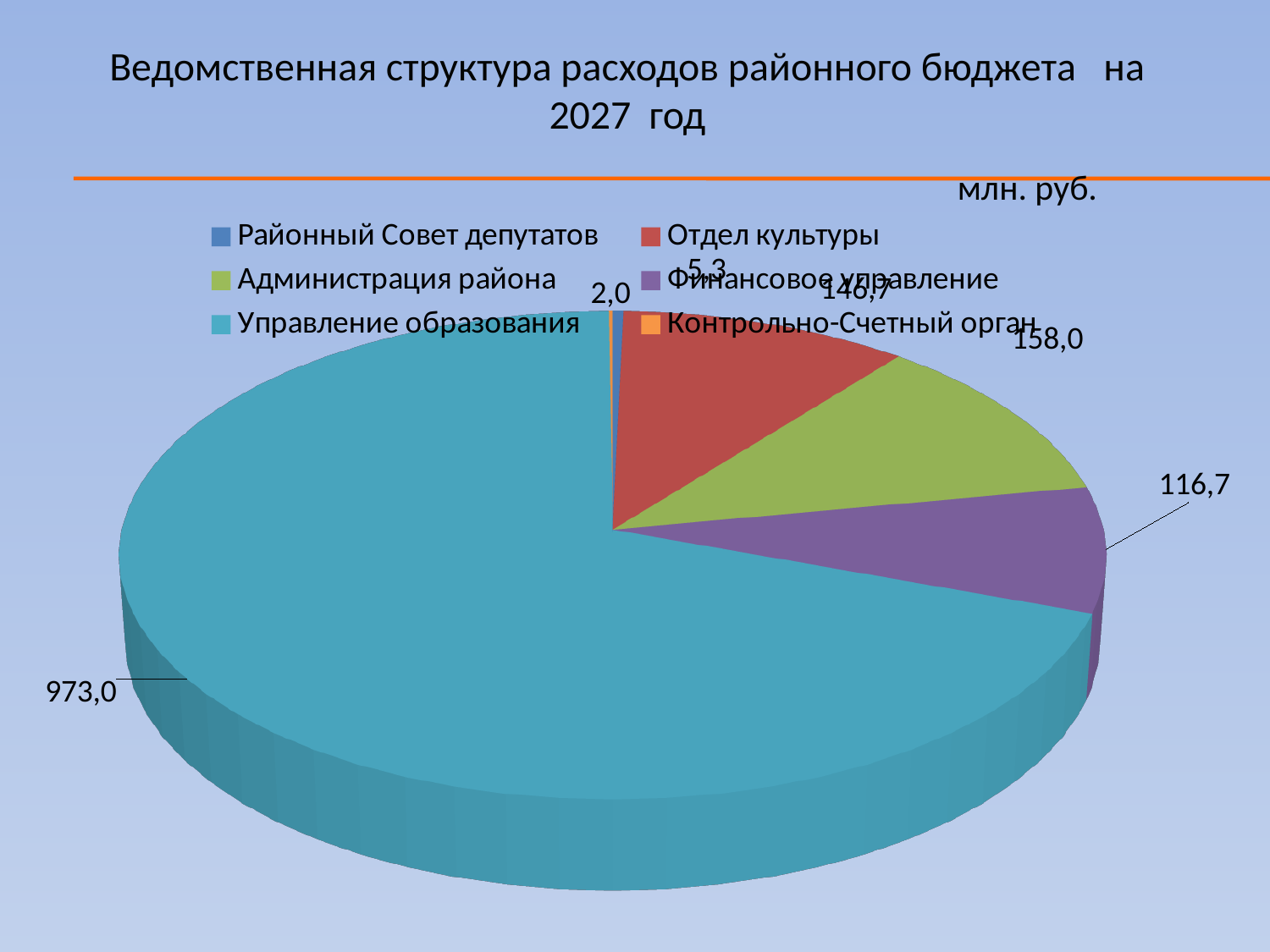
What is the value for Финансовое управление? 116,7 What is the value for Отдел культуры? 146,7 What is the difference between the values for Администрация района and Отдел культуры? 11,3 What is the difference between the values for Управление образования and Финансовое управление? 856,3 What is the value for Управление образования? 973,0 How many categories does the legend list? 6 Which is smaller, Финансовое управление or Отдел культуры? Финансовое управление What is the value for Администрация района? 158,0 Which is larger, Администрация района or Отдел культуры? Администрация района What kind of chart is shown on the slide? pie chart Which category has the largest slice of the pie? Управление образования In what units are the values on the chart given? млн. руб.